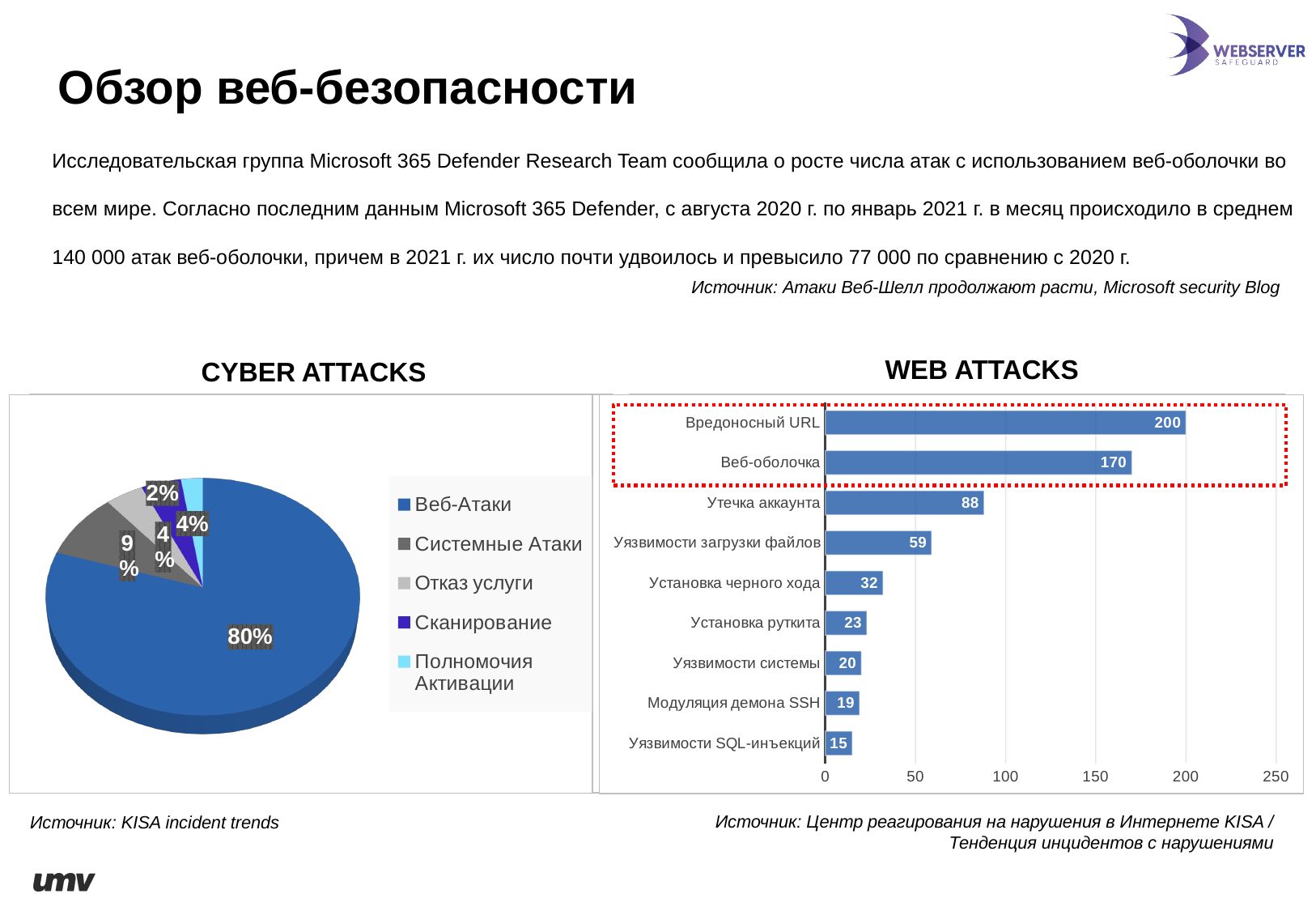
In the WEB ATTACKS chart, what is the value for Веб-оболочка? 170 In the WEB ATTACKS chart, which category has the lowest value? Уязвимости SQL-инъекций In the WEB ATTACKS chart, what is the value for Установка черного хода? 32 In the CYBER ATTACKS chart, what share do Веб-Атаки have? 80% In the WEB ATTACKS chart, which category has the highest value? Вредоносный URL In the WEB ATTACKS chart, what is the difference between Вредоносный URL and Веб-оболочка? 30 In the WEB ATTACKS chart, what is the value for Вредоносный URL? 200 In the CYBER ATTACKS chart, what share do Системные Атаки have? 9% In the WEB ATTACKS chart, which is larger: Утечка аккаунта or Уязвимости загрузки файлов? Утечка аккаунта How many entries does the legend of the CYBER ATTACKS chart list? 5 How many categories are shown in the WEB ATTACKS chart? 9 What type of chart is the WEB ATTACKS chart? Bar chart